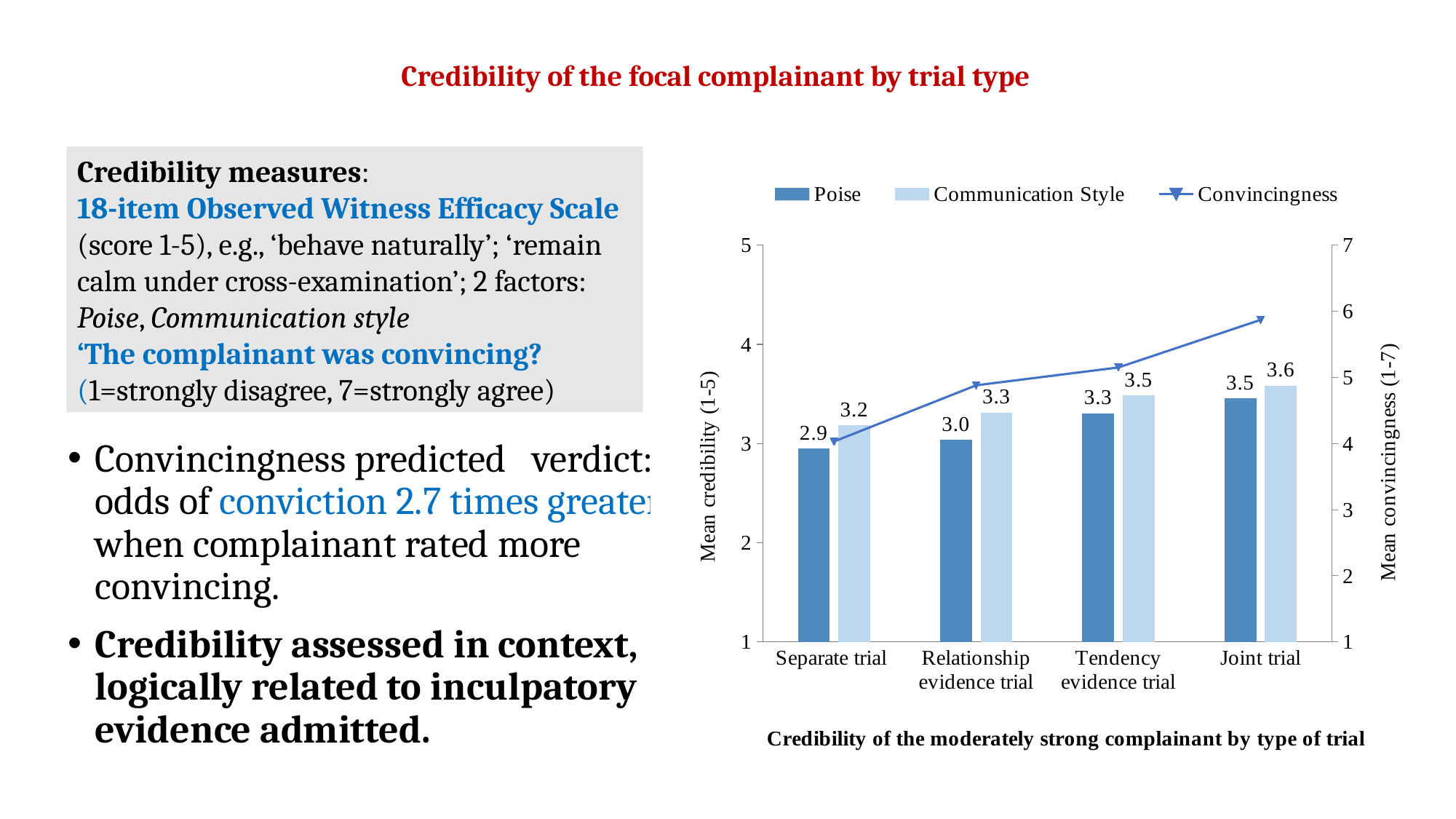
Is the Convincingness value for the Joint trial greater or less than 5 on the right-hand axis? greater What is the Communication Style value for the Joint trial? 3.6 Does the Convincingness line rise or fall from Separate trial to Joint trial? rise Which trial type has the lowest Communication Style value? Separate trial Is the Convincingness value for the Separate trial greater or less than 5 on the right-hand axis? less How many series does the legend list? 3 Which trial type has the highest Poise value? Joint trial Which is larger for the Relationship evidence trial, the Poise value or the Communication Style value? Communication Style How many trial types are shown on the x axis? 4 What is the difference between the Communication Style and Poise values for the Separate trial? 0.3 What is the Poise value for the Separate trial? 2.9 What is the Communication Style value for the Tendency evidence trial? 3.5